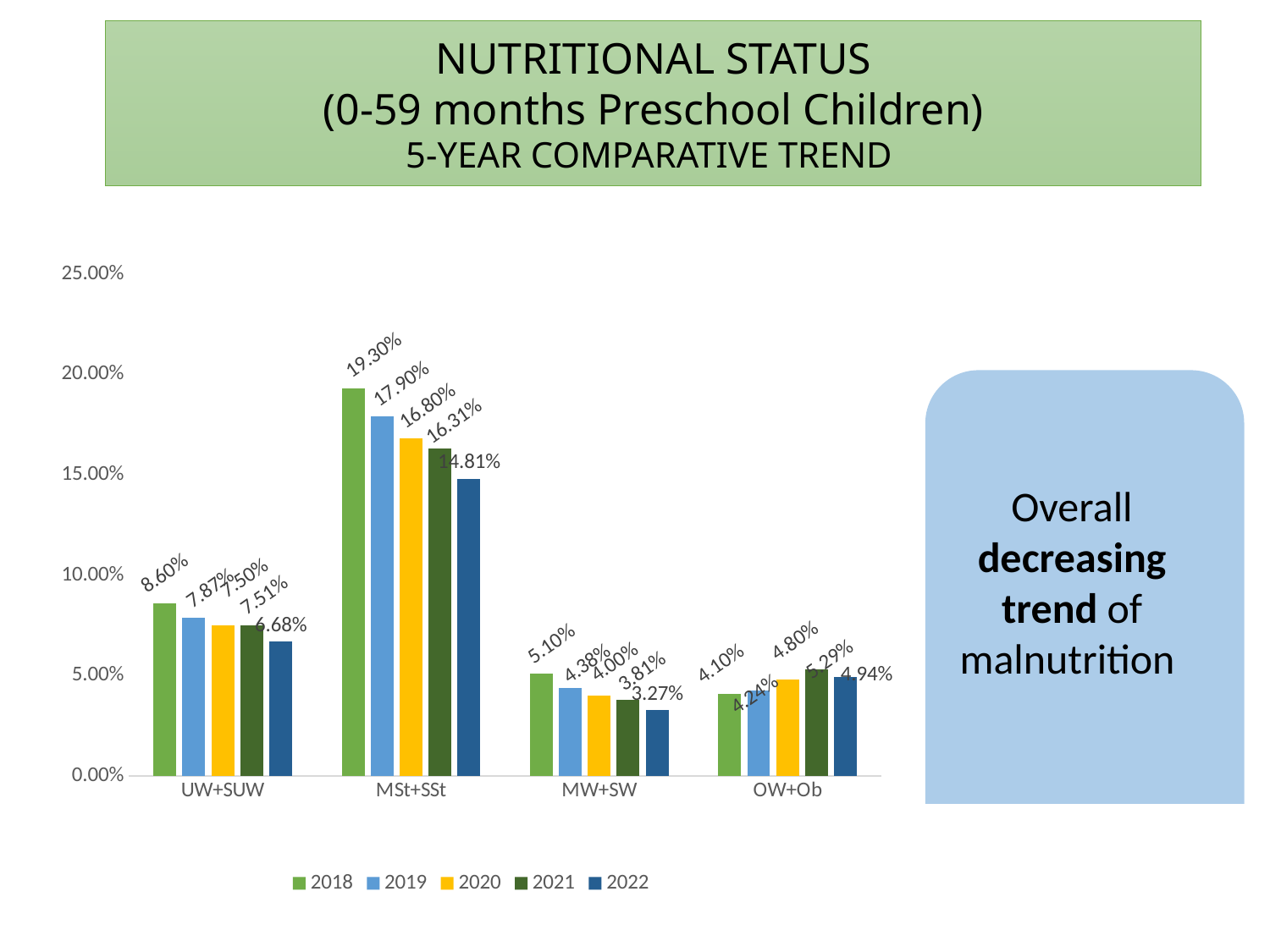
What is the value for UW+SUW in 2022? 6.68% Which category has the highest value in 2022? MSt+SSt What is the difference between the 2018 and 2022 values for MSt+SSt? 4.49% What is the value for MSt+SSt in 2018? 19.30% How many series does the legend list? 5 What is the value for MW+SW in 2020? 4.00% What is the value for OW+Ob in 2021? 5.29% Do the values for MW+SW rise or fall from 2018 to 2022? Fall What kind of chart is shown on the slide? Bar chart Which category has the lowest value in 2018? OW+Ob How many categories are shown on the x axis? 4 Which is larger, the 2019 value for UW+SUW or the 2019 value for MW+SW? UW+SUW